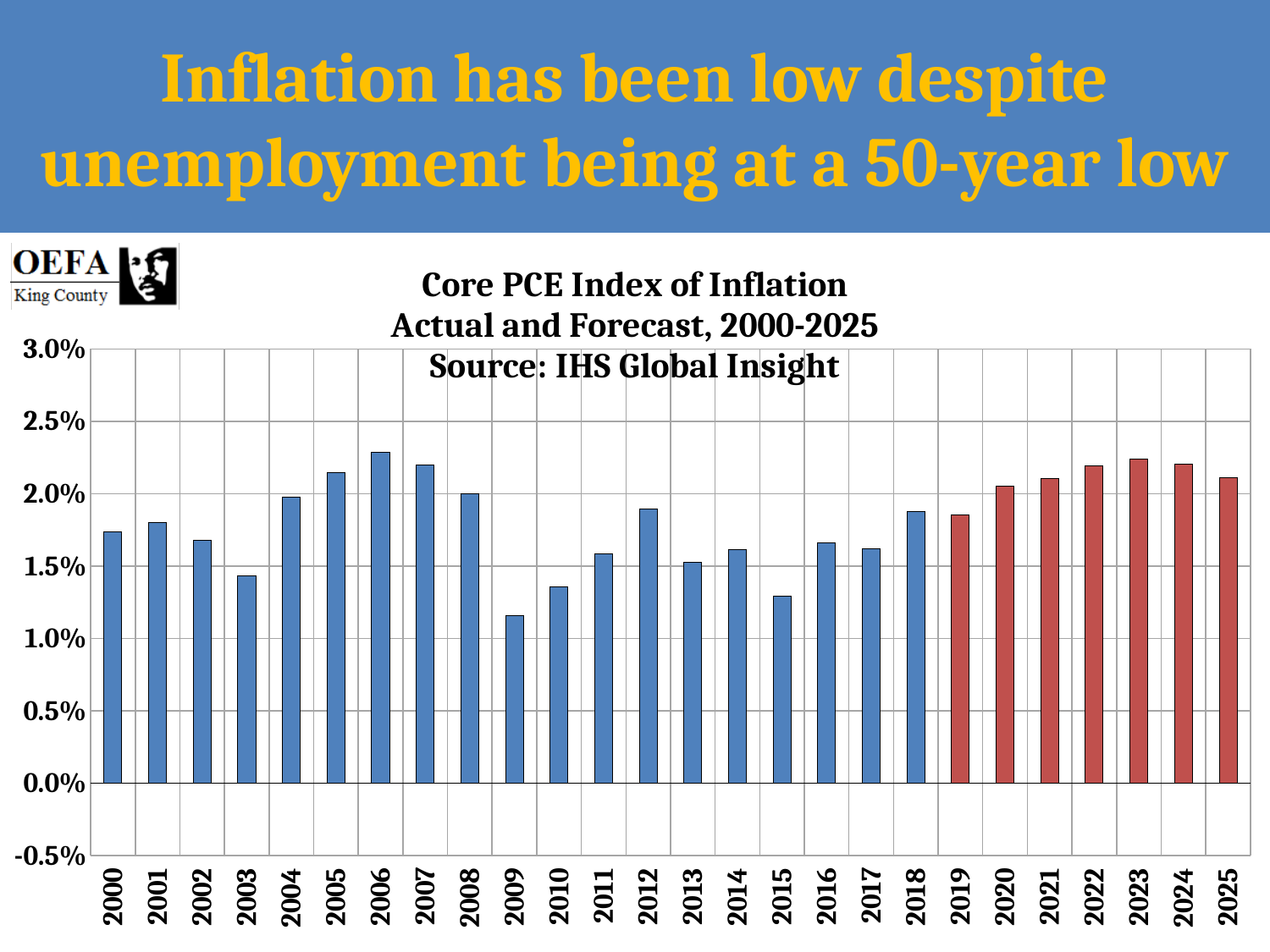
How many years are shown on the x axis of the chart? 26 What is the title of the chart? Core PCE Index of Inflation Actual and Forecast, 2000-2025 Which year has the higher value, 2012 or 2013? 2012 What kind of chart is shown on the slide? Bar chart Is the value for 2006 greater or less than 2.0%? greater Is the value for 2023 greater or less than 2.0%? greater Do the values rise or fall from 2019 to 2023? Rise Is the value for 2009 greater or less than 1.5%? less Which year has the higher value, 2006 or 2009? 2006 What source is cited for the chart's data? IHS Global Insight Which year has the lowest Core PCE inflation value in the chart? 2009